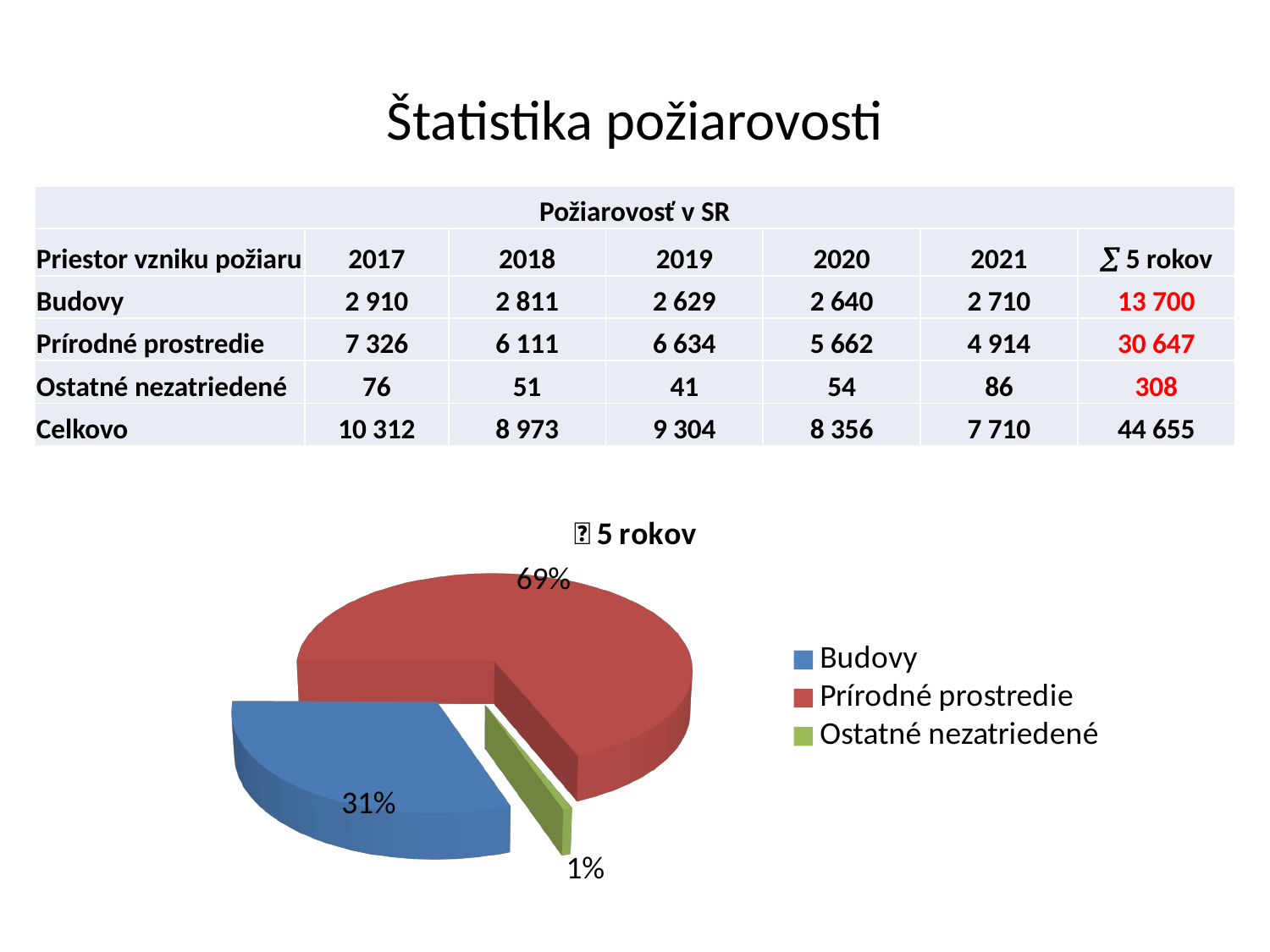
What kind of chart is shown on the slide? pie chart How many slices does the pie chart have? 3 What share of the pie does Budovy have? 31% What share of the pie does Ostatné nezatriedené have? 1% What share of the pie does Prírodné prostredie have? 69% Which slice is larger, Budovy or Ostatné nezatriedené? Budovy By how many percentage points does the Prírodné prostredie share exceed the Budovy share? 38 percentage points Which slice is larger, Budovy or Prírodné prostredie? Prírodné prostredie Which category has the smallest slice of the pie? Ostatné nezatriedené Which category has the largest slice of the pie? Prírodné prostredie What colour is the Budovy slice in the pie chart? blue How many entries does the chart legend list? 3